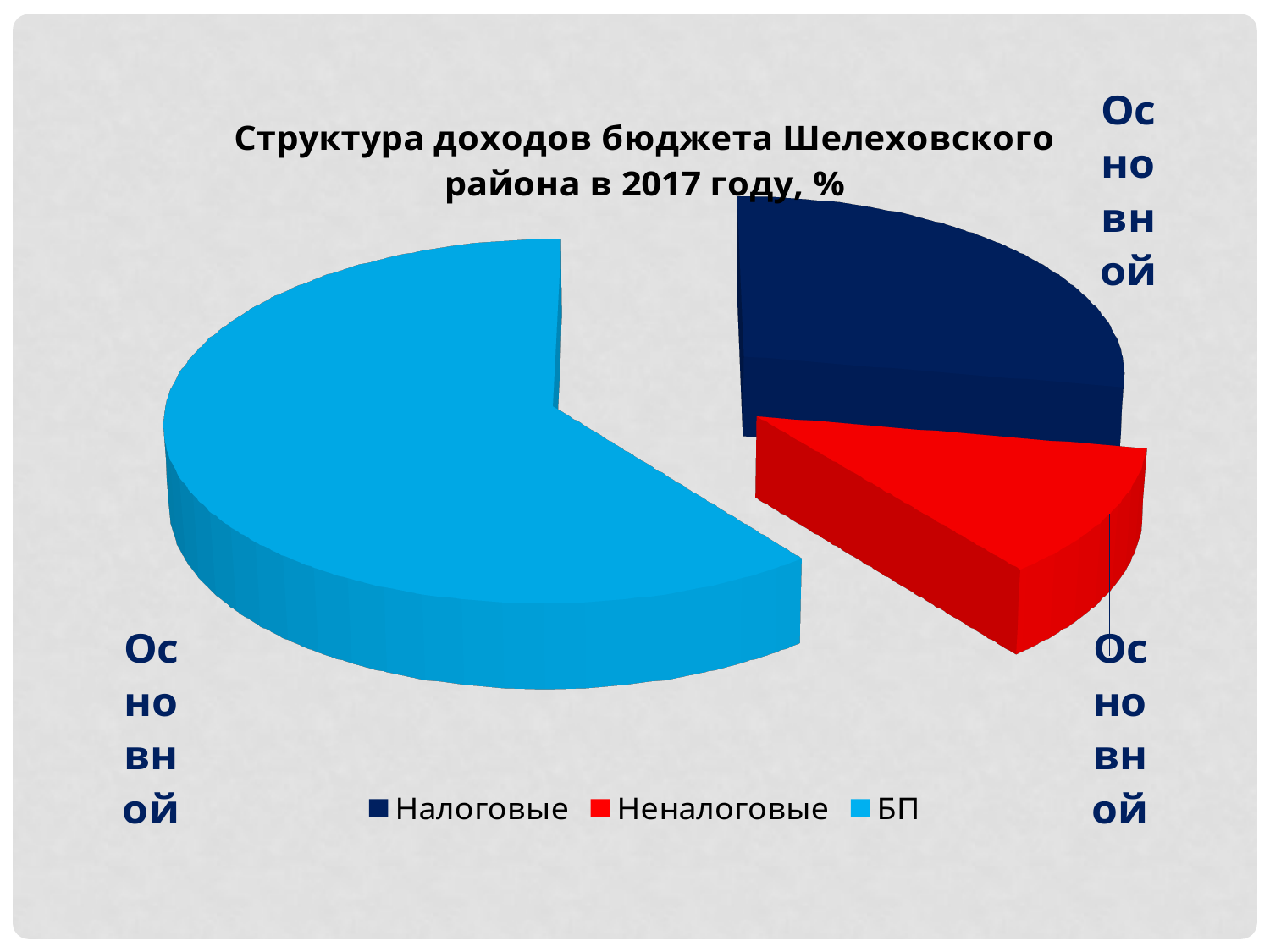
What kind of chart is shown on the slide? pie chart Which slice is larger, БП or Налоговые? БП What is the title of the chart? Структура доходов бюджета Шелеховского района в 2017 году, % How many slices does the pie chart have? 3 Which category has the smallest slice of the pie? Неналоговые Which category has the largest slice of the pie? БП What colour is the slice for Неналоговые? red Which slice is larger, Налоговые or Неналоговые? Налоговые How many entries does the legend list? 3